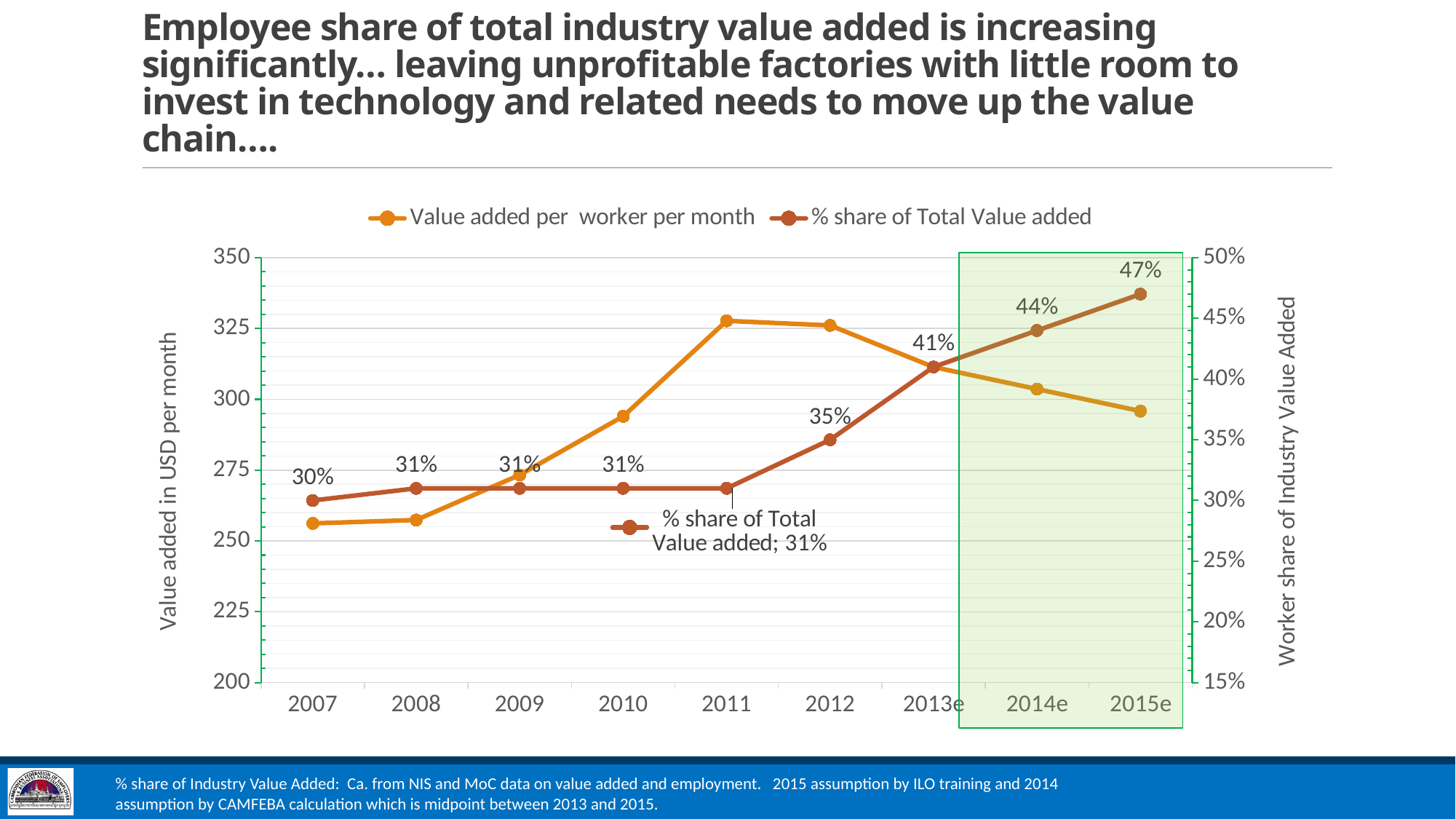
What is the difference in % share of Total Value added between 2015e and 2013e? 6% Is the Value added per worker per month in 2011 greater or less than 300? greater What is the % share of Total Value added in 2007? 30% Does the Value added per worker per month rise or fall from 2011 to 2015e? fall What kind of chart is shown on the slide? line chart Is the % share of Total Value added larger in 2014e or in 2012? 2014e How many years are shown on the x axis? 9 In which year is the % share of Total Value added lowest? 2007 What is the % share of Total Value added in 2015e? 47% How many series does the legend list? 2 What is the % share of Total Value added in 2012? 35% In which year is the % share of Total Value added highest? 2015e